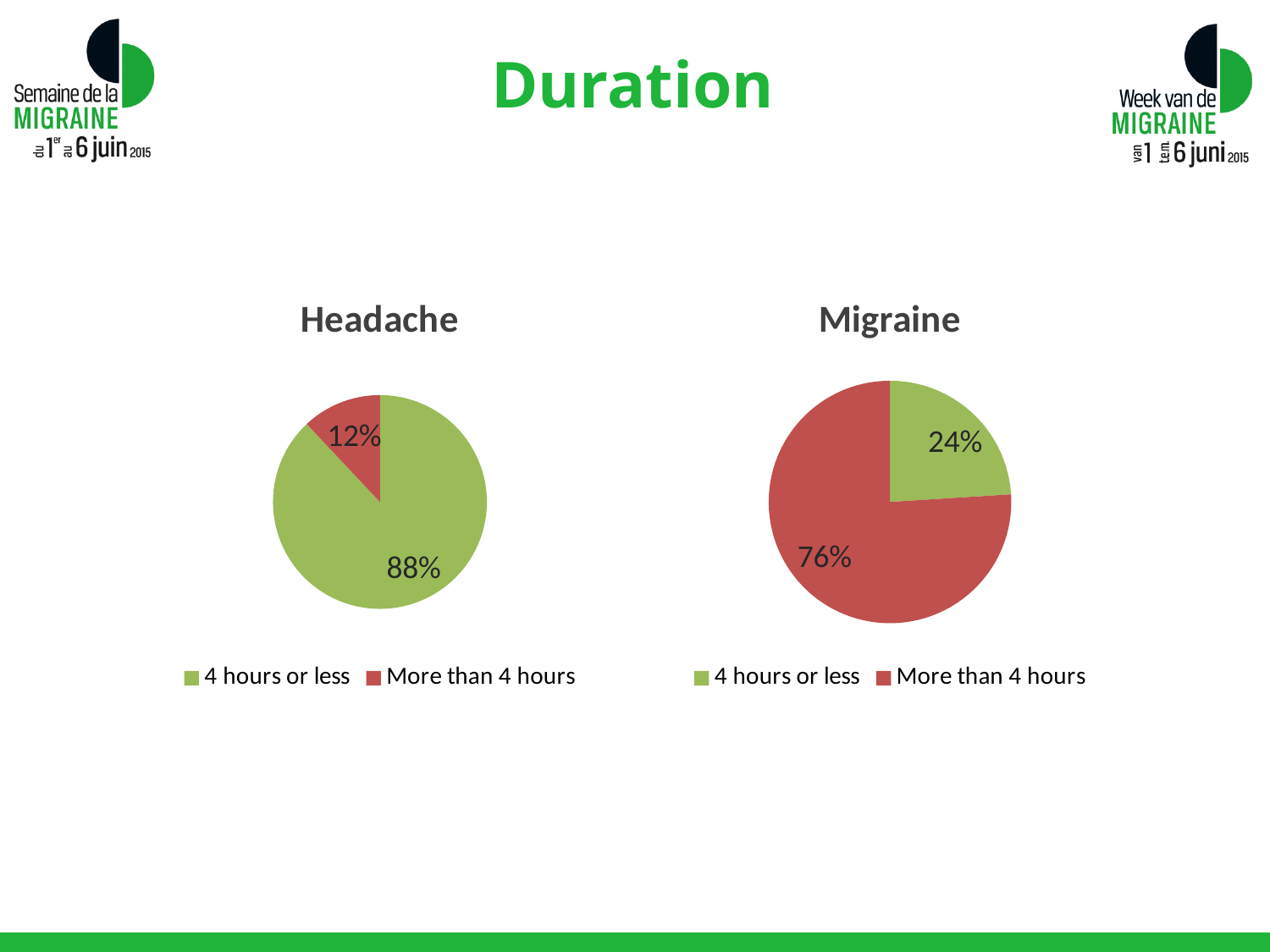
In the Migraine chart, which category has the smallest slice? 4 hours or less Is the '4 hours or less' share larger in the Headache chart or the Migraine chart? Headache How many categories does the legend of the Migraine chart list? 2 What type of chart is the Headache chart? Pie chart In the Migraine chart, what is the difference between the 'More than 4 hours' and '4 hours or less' shares? 52% In the Migraine chart, what colour is the 'More than 4 hours' slice? Red In the Migraine chart, what share of the pie is '4 hours or less'? 24% In the Headache chart, which category has the largest slice? 4 hours or less In the Headache chart, what share of the pie is 'More than 4 hours'? 12% In the Headache chart, what is the difference between the '4 hours or less' and 'More than 4 hours' shares? 76% In the Migraine chart, what share of the pie is 'More than 4 hours'? 76% In the Headache chart, what share of the pie is '4 hours or less'? 88%